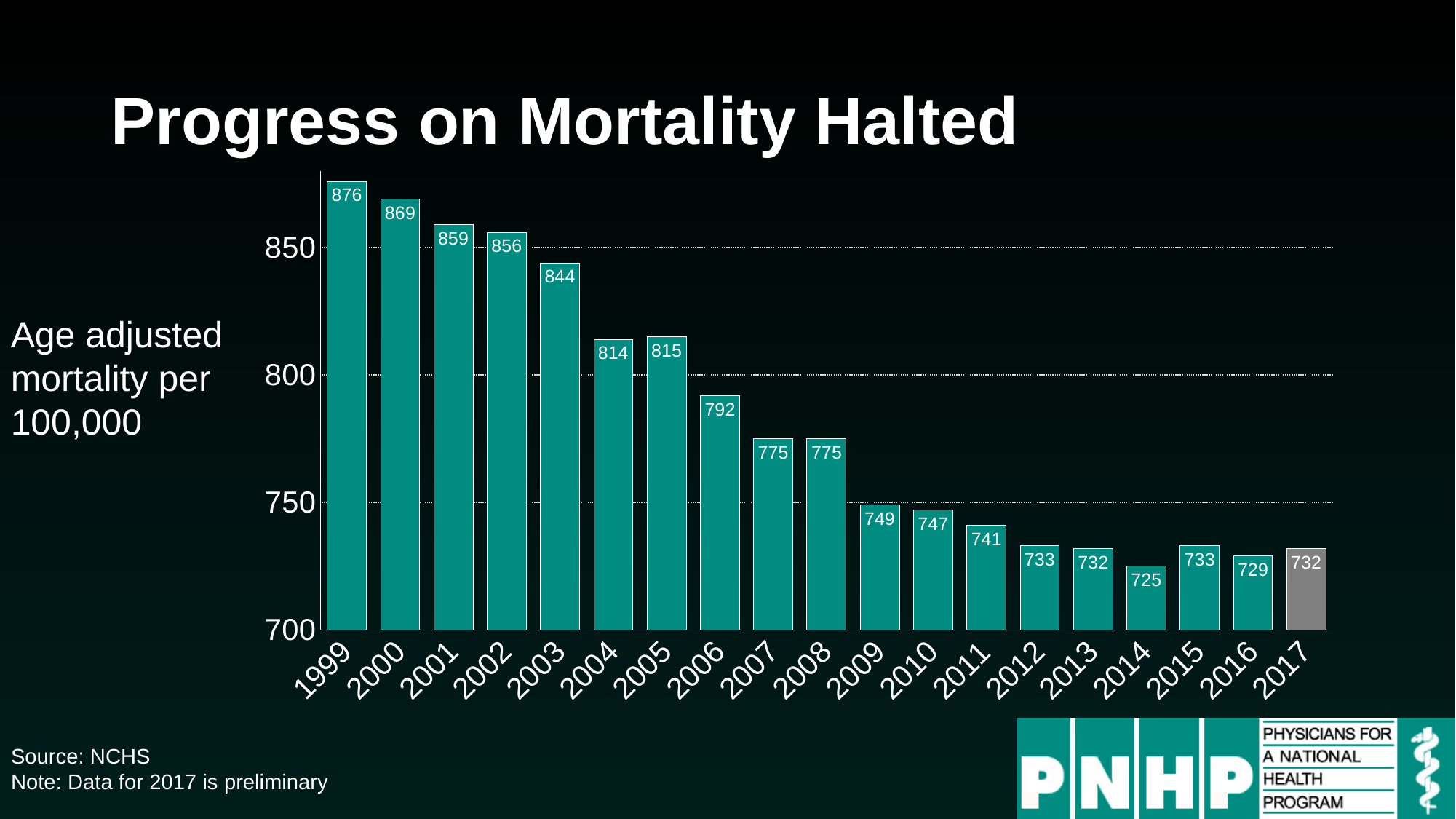
Is the value for 2008 greater or less than 800? less What is the difference in age adjusted mortality between 1999 and 2017? 144 How many years are shown on the x axis? 19 What is the age adjusted mortality per 100,000 for 2014? 725 Which year has the lowest age adjusted mortality? 2014 Do the values generally rise or fall from 1999 to 2017? fall What is the age adjusted mortality per 100,000 for 2017? 732 Which year has the highest age adjusted mortality? 1999 Which year has a higher age adjusted mortality, 2006 or 2009? 2006 What kind of chart is shown on the slide? bar chart What is the difference in age adjusted mortality between 2003 and 2004? 30 What is the age adjusted mortality per 100,000 for 1999? 876